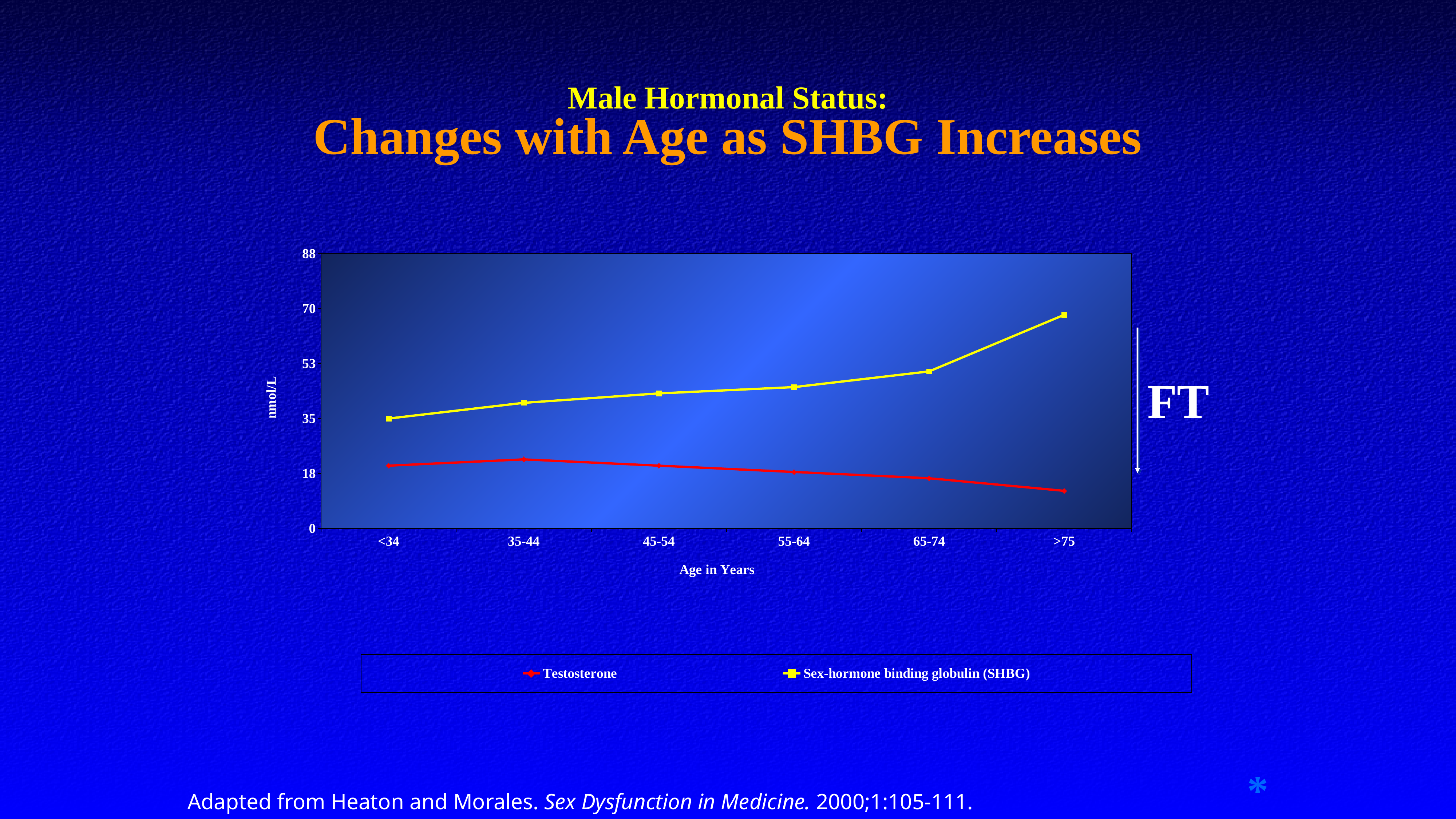
Is the SHBG value for the 45-54 age group greater or less than 35? greater Does the Testosterone line rise or fall from the 35-44 age group to the >75 age group? falls Which age group has the lowest Testosterone value? >75 Is the SHBG value for the >75 age group greater or less than 53? greater What unit is shown on the y axis of the chart? nmol/L How many series does the legend list? 2 How many age groups are shown on the x axis? 6 At the 55-64 age group, which series has the larger value, Testosterone or SHBG? Sex-hormone binding globulin (SHBG) Does the Sex-hormone binding globulin (SHBG) line rise or fall as age increases? rises Which age group has the highest SHBG value? >75 Is the Testosterone value for the >75 age group greater or less than 18? less What kind of chart is shown on the slide? line chart